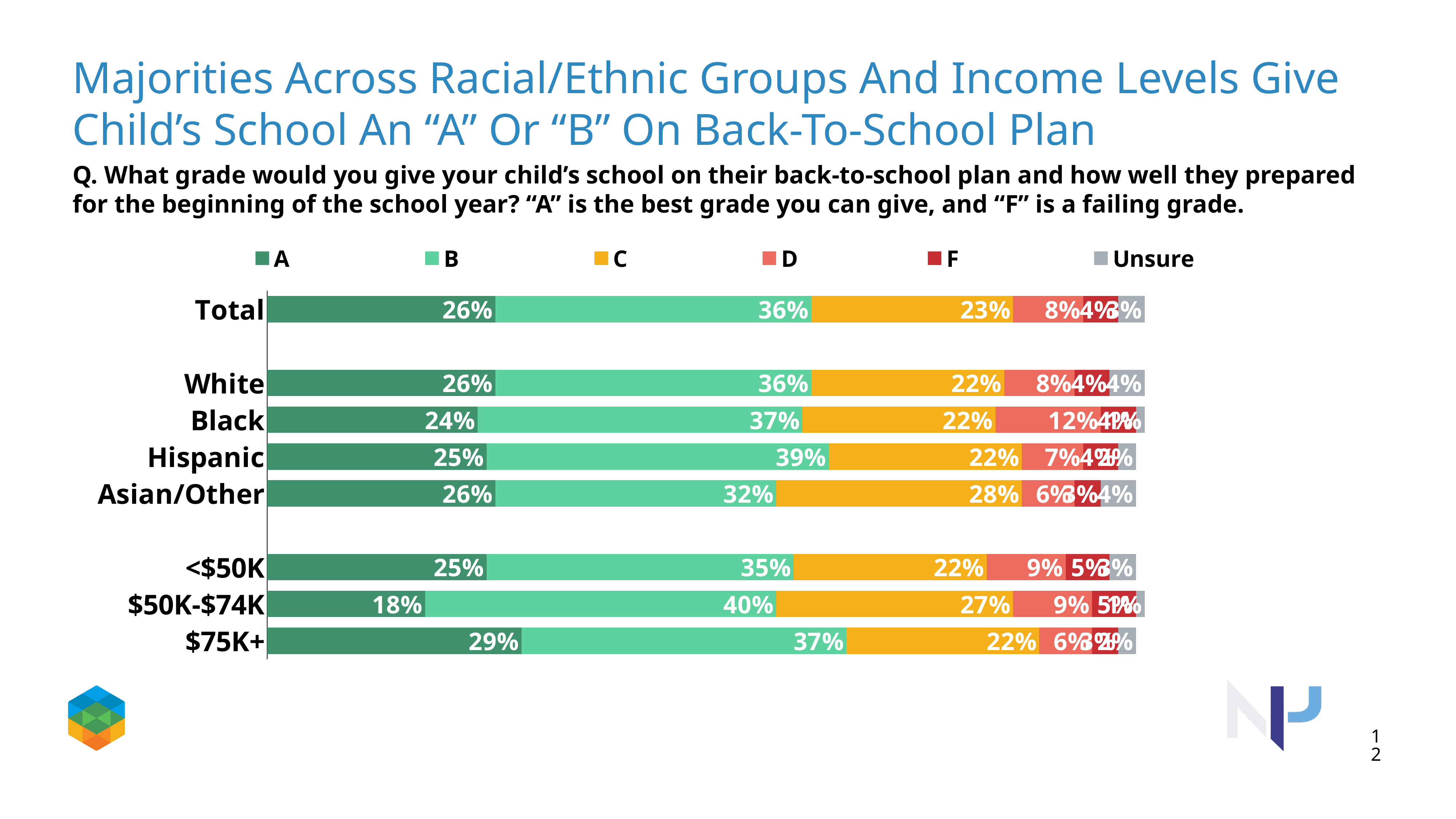
How many percentage points higher is the "A" share for $75K+ than for $50K-$74K? 11 percentage points Which group has the lowest share giving an "A" grade? $50K-$74K How many series does the legend list? 6 Which group has the highest share giving an "A" grade? $75K+ What percentage of Black respondents gave a "D" grade? 12% What percentage of the $75K+ group gave their child's school an "A"? 29% Which group has the highest share giving a "B" grade? $50K-$74K Which group has a larger "B" share, Hispanic or Asian/Other? Hispanic What type of chart is shown on the slide? Stacked bar chart How many groups (bars) are shown in the chart? 8 What is the "C" value for the Asian/Other group? 28% What percentage of Hispanic respondents gave a "B" grade? 39%